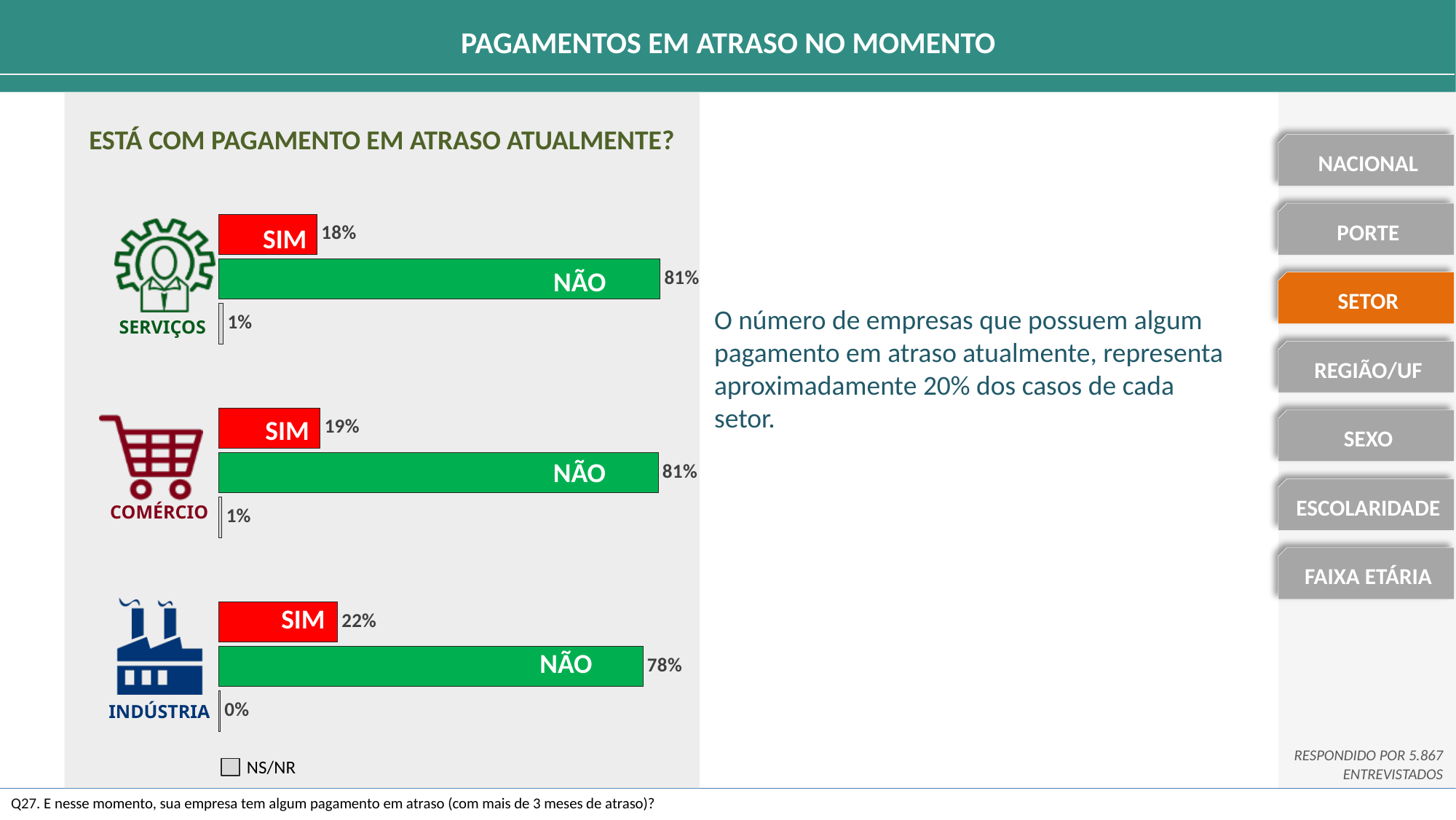
Which is larger, the SIM percentage for Comércio or the SIM percentage for Serviços? Comércio What is the total of SIM, NÃO and NS/NR for Serviços? 100% Which sector has the highest SIM percentage? Indústria What type of chart is used to show the responses? Bar chart What percentage of Serviços companies answered SIM (have a payment in arrears)? 18% What percentage of Comércio companies answered NÃO? 81% What colour are the NÃO bars? Green What is the NS/NR percentage for Indústria? 0% What percentage of Indústria companies answered SIM? 22% How many sectors are shown in the chart? 3 Which sector has the lowest NÃO percentage? Indústria What is the difference between the SIM percentages for Indústria and Serviços? 4%